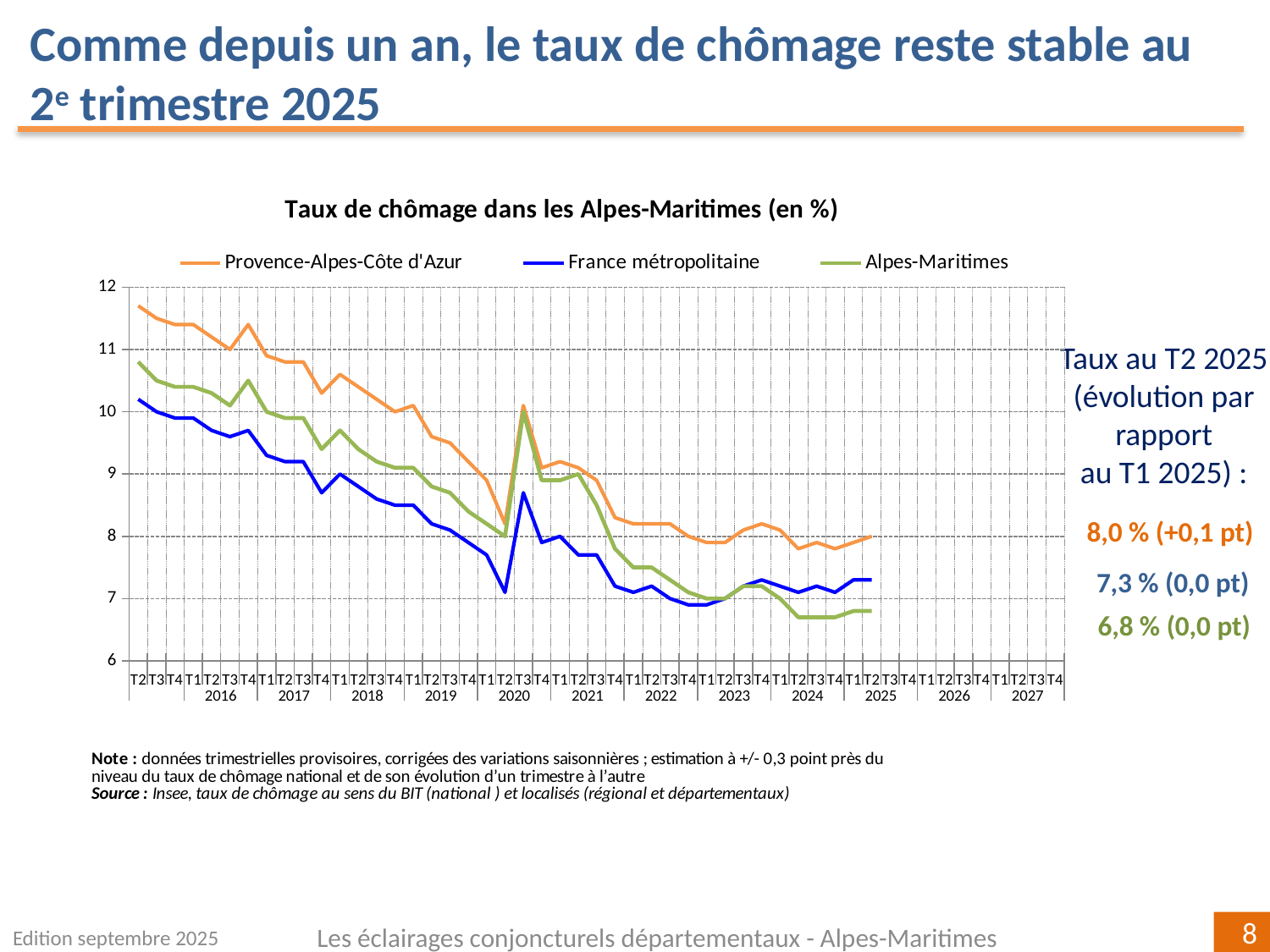
What is the unemployment rate for Alpes-Maritimes at T2 2025? 6,8 % What is the change in the Provence-Alpes-Côte d'Azur rate at T2 2025 compared with T1 2025? +0,1 pt At T2 2025, which is higher: the rate for France métropolitaine or for Alpes-Maritimes? France métropolitaine What is the unemployment rate for France métropolitaine at T2 2025? 7,3 % Is the value for Alpes-Maritimes at T1 2016 greater or less than 10? greater How many series does the legend list? 3 What kind of chart is shown on the slide? line chart At T2 2025, what is the difference between the Provence-Alpes-Côte d'Azur rate and the Alpes-Maritimes rate? 1,2 points Which series has the highest value at T2 2025? Provence-Alpes-Côte d'Azur Which series has the lowest value at T2 2025? Alpes-Maritimes Overall, does the Alpes-Maritimes unemployment rate rise or fall between 2016 and 2025? fall What is the unemployment rate for Provence-Alpes-Côte d'Azur at T2 2025? 8,0 %